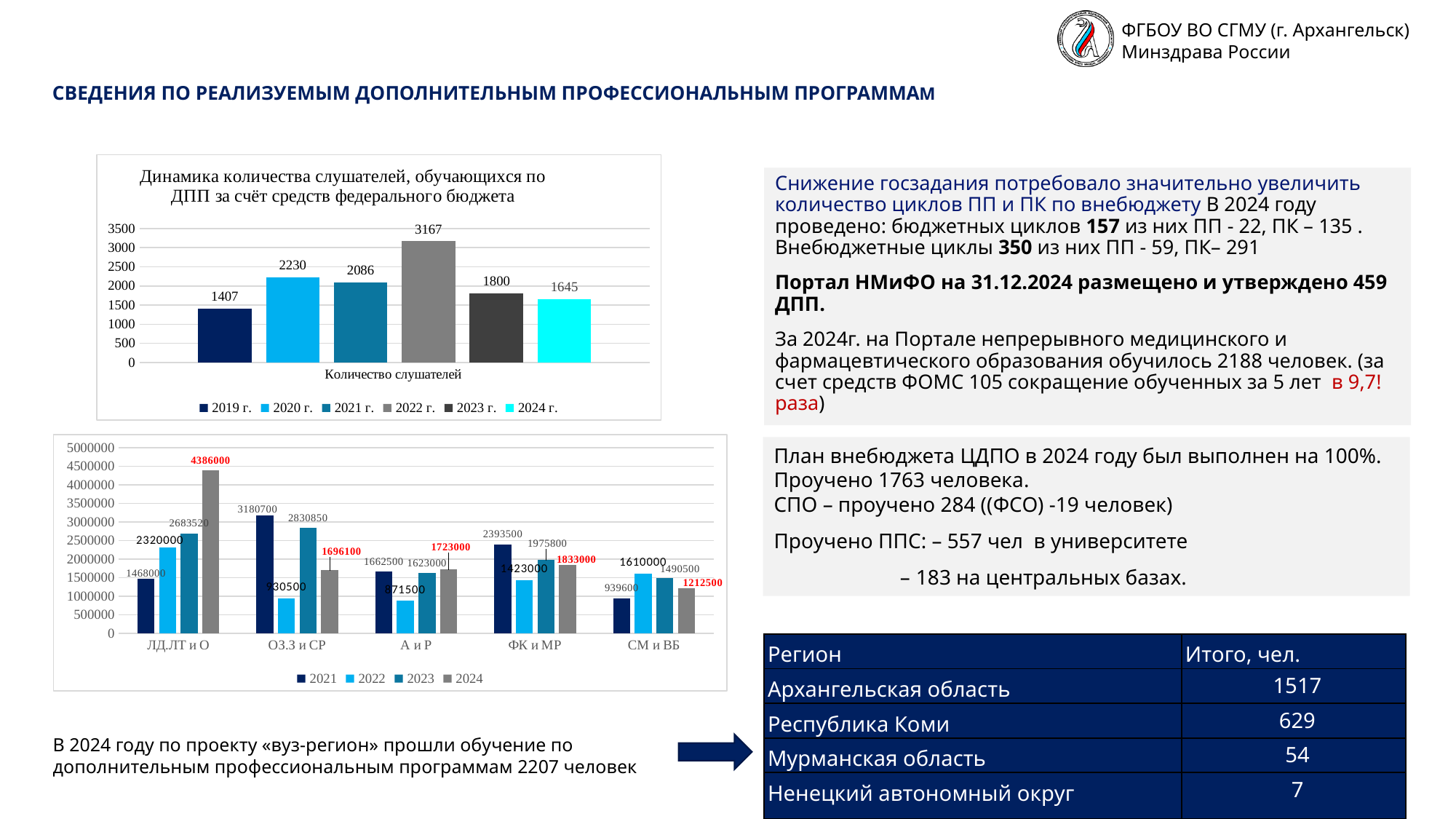
In the bottom chart, is the value for 2023 in the category А и Р greater or less than 2000000? less In the top chart 'Динамика количества слушателей', what is the difference between the 2022 г. and 2023 г. values? 1367 In the bottom chart, how many categories are shown on the x axis? 5 In the top chart 'Динамика количества слушателей', which is larger, the value for 2020 г. or 2021 г.? 2020 г. What kind of chart is the top chart 'Динамика количества слушателей'? Bar chart In the bottom chart, which series has the highest value in the category ФК и МР? 2021 In the top chart 'Динамика количества слушателей, обучающихся по ДПП за счёт средств федерального бюджета', what is the value for 2022 г.? 3167 In the bottom chart, what is the value for 2022 in the category ОЗ.З и СР? 930500 In the bottom chart, what is the value for 2024 in the category ЛД,ЛТ и О? 4386000 In the top chart 'Динамика количества слушателей', how many series does the legend list? 6 In the top chart 'Динамика количества слушателей', which year has the lowest number of listeners? 2019 г. In the bottom chart, what is the difference between the 2021 and 2022 values in the category СМ и ВБ? 670400